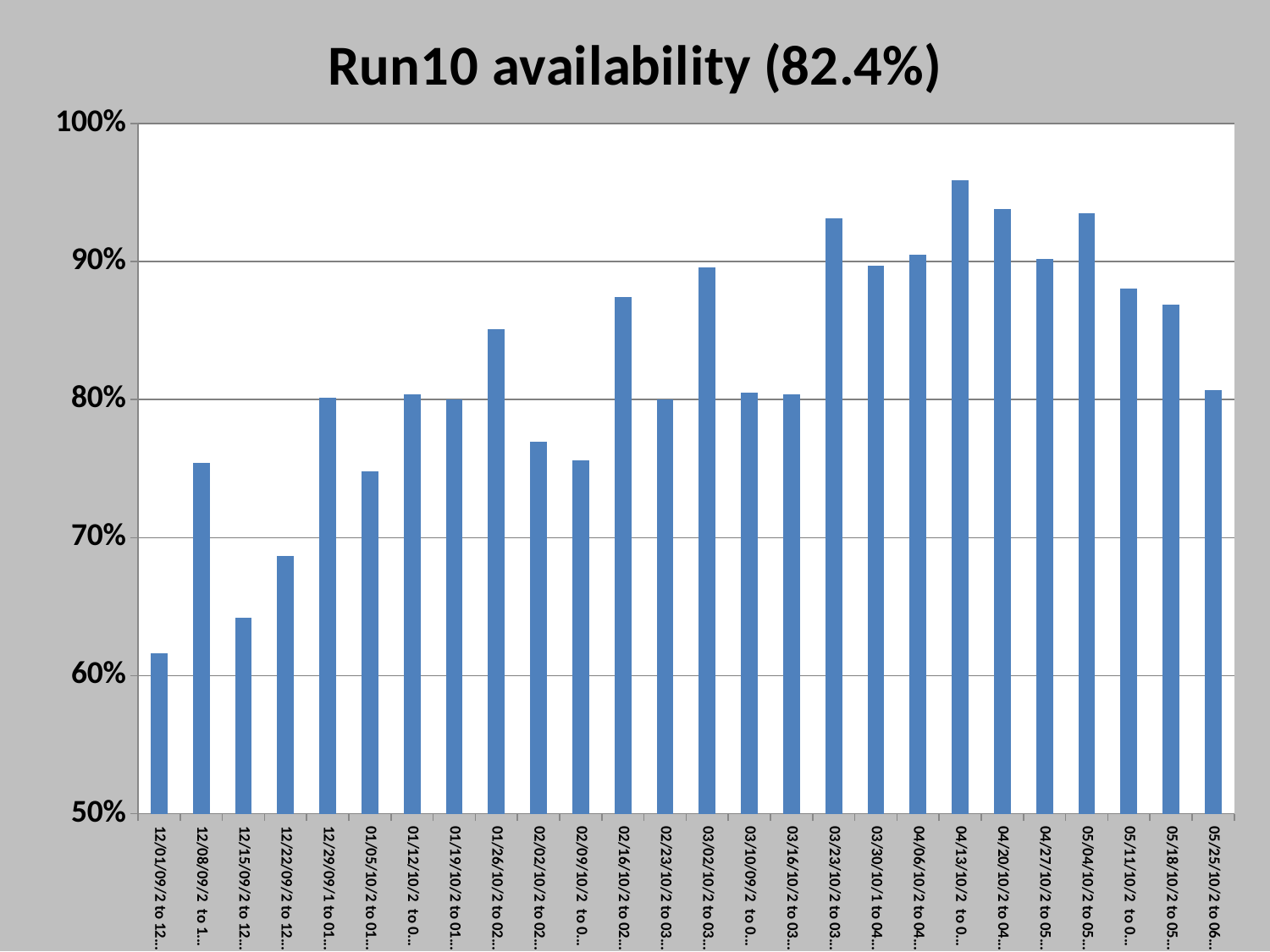
What is the title of the chart? Run10 availability (82.4%) Which is larger, the value for the period starting 04/13/10 or the period starting 04/20/10? 04/13/10 Is the value for the period starting 04/13/10 greater or less than 90%? greater Which is larger, the value for the period starting 12/08/09 or the period starting 12/15/09? 12/08/09 What kind of chart is shown on the slide? Bar chart Is the value for the period starting 02/02/10 greater or less than 80%? less How many bars (weekly periods) are plotted in the chart? 26 Which period has the highest availability? 04/13/10 Is the value for the period starting 12/22/09 greater or less than 70%? less Which period has the lowest availability? 12/01/09